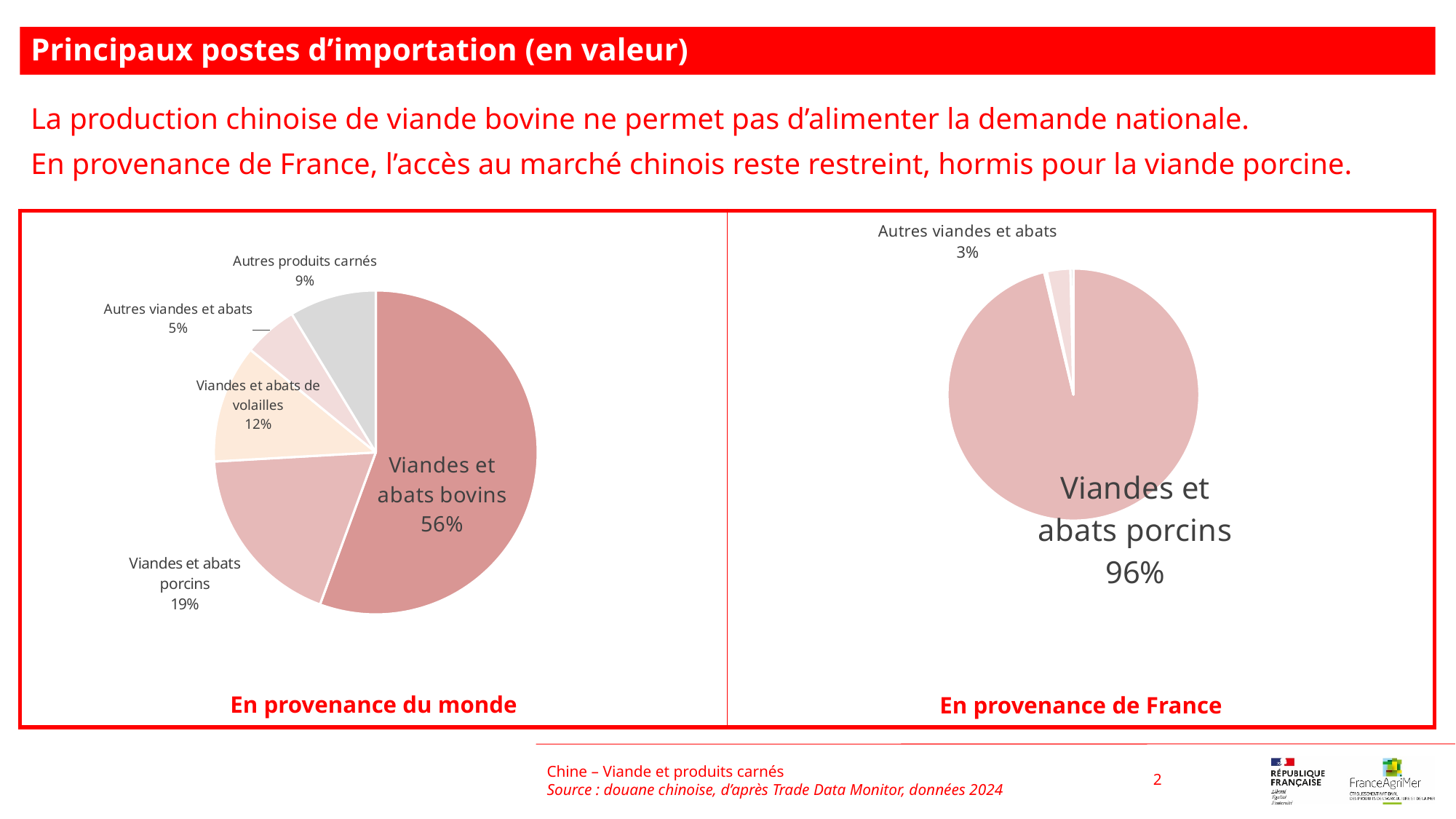
In the 'En provenance du monde' chart, what is the difference in percentage points between Viandes et abats bovins and Viandes et abats porcins? 37 In the 'En provenance du monde' chart, what share do Viandes et abats bovins represent? 56% In the 'En provenance du monde' chart, what percentage is shown for Autres produits carnés? 9% In the 'En provenance du monde' chart, how many categories are shown? 5 In the 'En provenance de France' chart, what percentage is shown for Autres viandes et abats? 3% In the 'En provenance du monde' chart, what is the share of Viandes et abats porcins? 19% In the 'En provenance de France' chart, what share do Viandes et abats porcins represent? 96% What type of chart is used on this slide? Pie chart In the 'En provenance du monde' chart, which is larger: Viandes et abats de volailles or Autres produits carnés? Viandes et abats de volailles In the 'En provenance du monde' chart, which category has the largest share? Viandes et abats bovins In the 'En provenance du monde' chart, what percentage is shown for Viandes et abats de volailles? 12% In the 'En provenance du monde' chart, which category has the smallest share? Autres viandes et abats